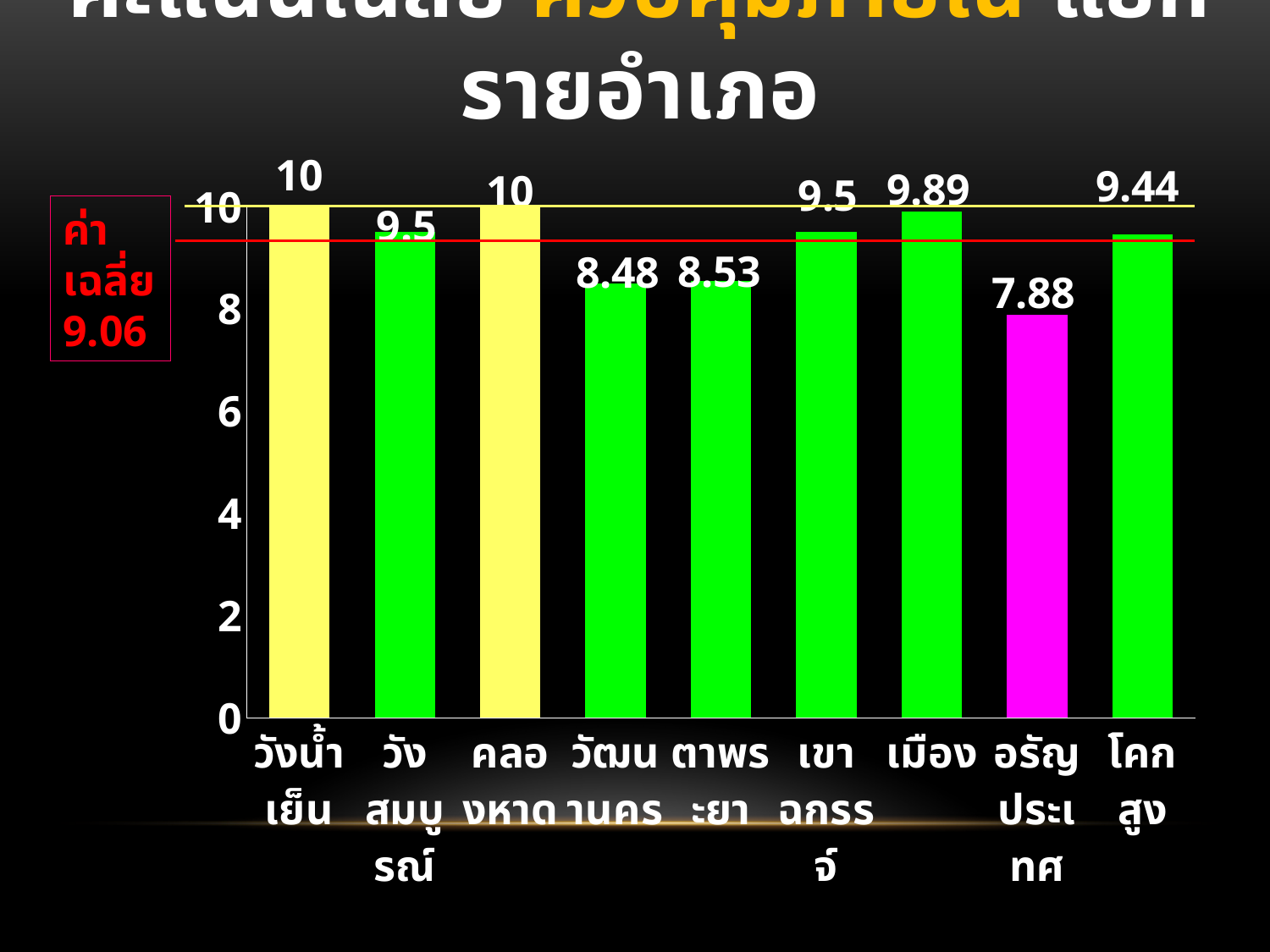
What is the difference between the values for เมือง and อรัญประเทศ? 2.01 What is the value for โคกสูง? 9.44 What average value (ค่าเฉลี่ย) is shown in the box on the left of the chart? 9.06 Which category has the lowest value? อรัญประเทศ What kind of chart is shown on the slide? bar chart Which is larger, the value for เมือง or the value for โคกสูง? เมือง What is the difference between the values for ตาพระยา and วัฒนานคร? 0.05 What is the value for เมือง? 9.89 How many categories are shown on the x axis? 9 Is the value for อรัญประเทศ greater or less than 8? less What is the value for วัฒนานคร? 8.48 What is the value for อรัญประเทศ? 7.88